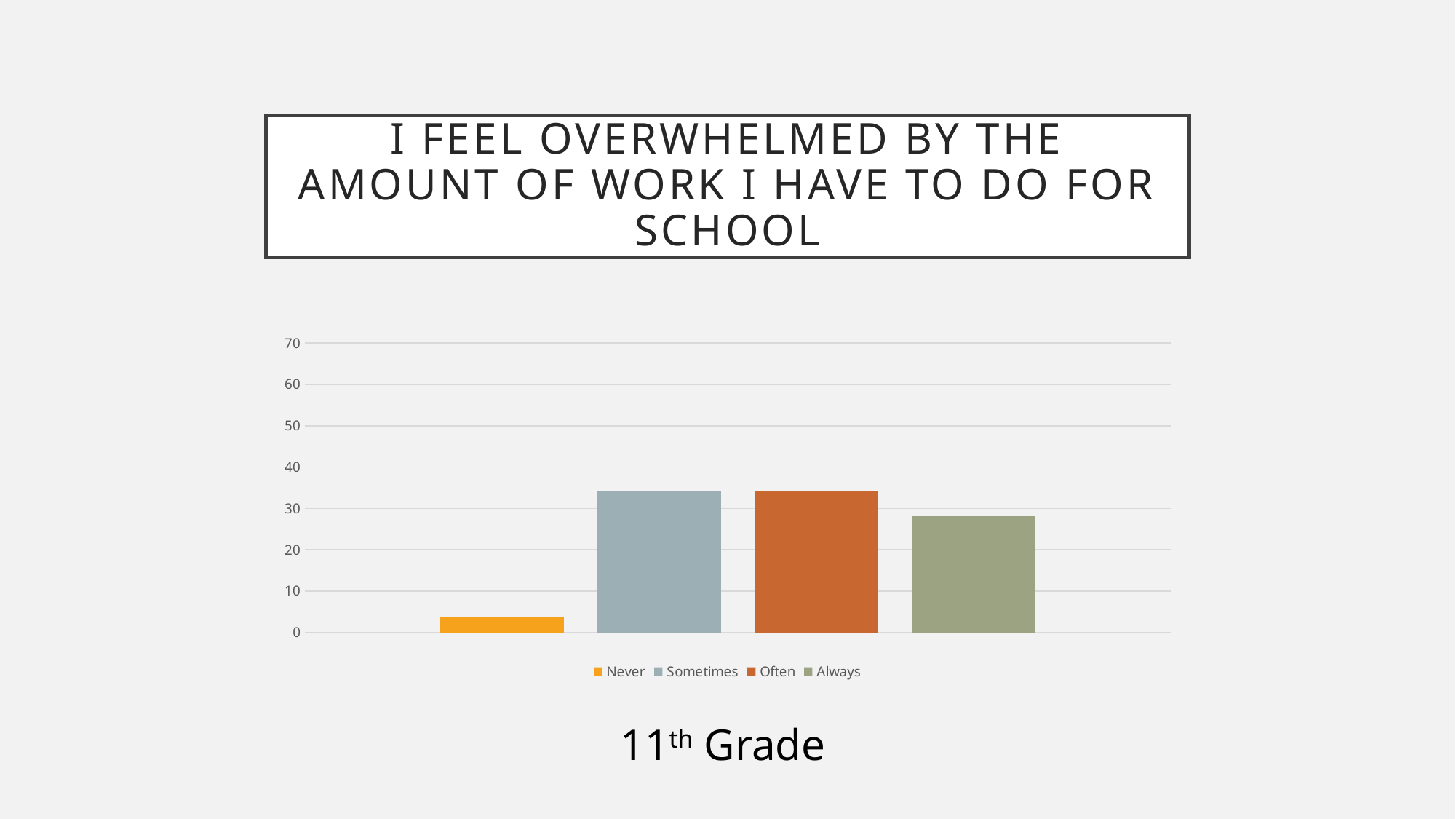
Which is larger, the value for Sometimes or the value for Always? Sometimes Is the value for Never greater or less than 10? less How many bars are plotted in the chart? 4 Which response has the lowest bar? Never Is the value for Often greater or less than 30? greater What kind of chart is shown on the slide? bar chart Is the value for Sometimes greater or less than 30? greater How many series does the legend list? 4 Which is larger, the value for Always or the value for Never? Always Which legend entry is shown in orange-brown (the third colour in the legend)? Often